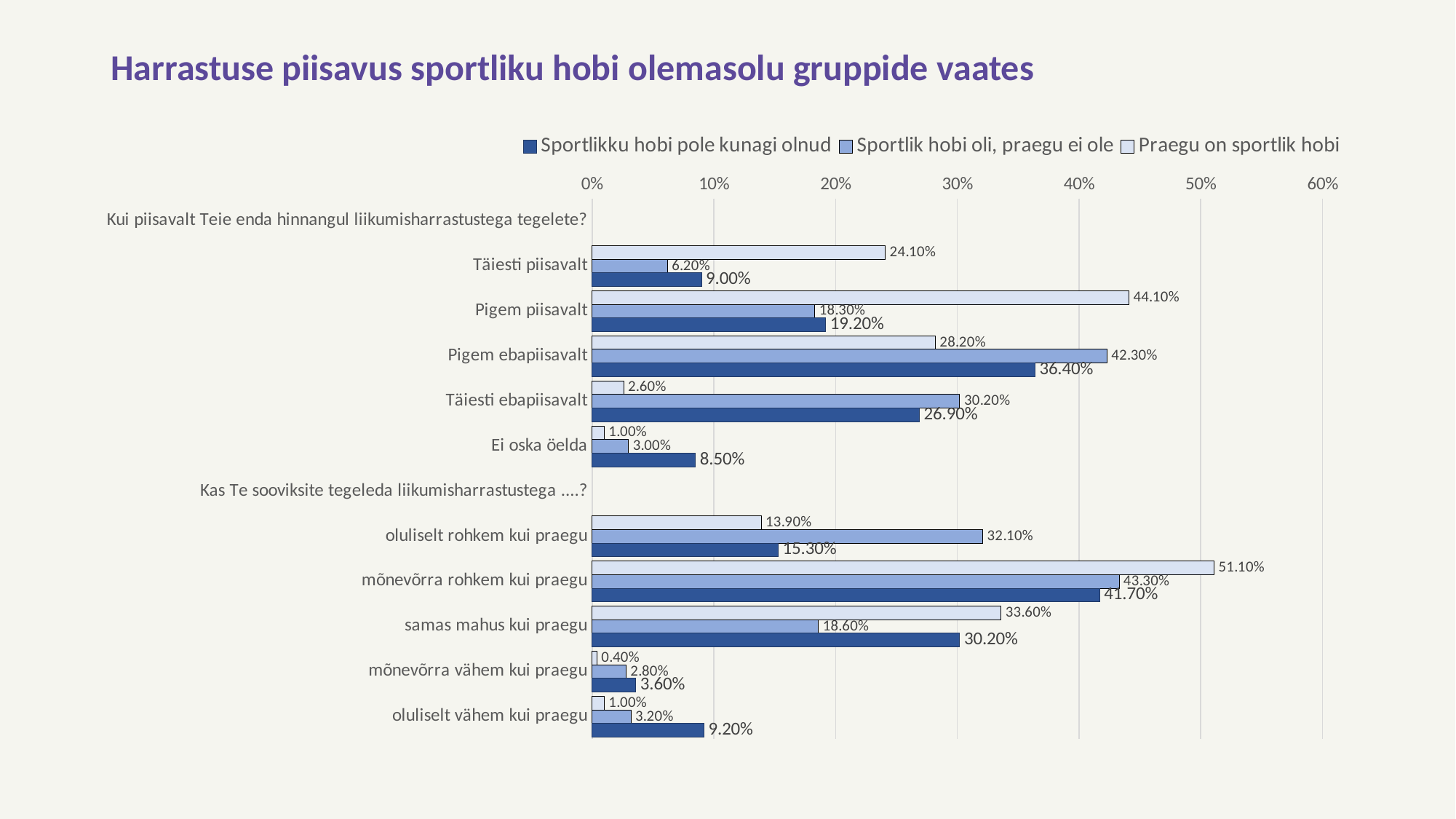
How many series does the legend list? 3 What is the difference between the "Praegu on sportlik hobi" and "Sportlikku hobi pole kunagi olnud" values in the "Täiesti piisavalt" category? 15.10% What is the value for "Sportlikku hobi pole kunagi olnud" in the "samas mahus kui praegu" category? 30.20% What is the value for "Sportlik hobi oli, praegu ei ole" in the "oluliselt rohkem kui praegu" category? 32.10% What is the value for "Praegu on sportlik hobi" in the "Pigem piisavalt" category? 44.10% What is the value for "Sportlikku hobi pole kunagi olnud" in the "Täiesti ebapiisavalt" category? 26.90% Which category has the lowest value for the "Praegu on sportlik hobi" series? mõnevõrra vähem kui praegu What is the title of the chart? Harrastuse piisavus sportliku hobi olemasolu gruppide vaates In the "Pigem ebapiisavalt" category, which series has the larger value: "Sportlik hobi oli, praegu ei ole" or "Praegu on sportlik hobi"? Sportlik hobi oli, praegu ei ole What type of chart is shown on the slide? bar chart Is the value for "Praegu on sportlik hobi" in the "mõnevõrra rohkem kui praegu" category greater or less than 50%? greater Which category has the highest value for the "Praegu on sportlik hobi" series? mõnevõrra rohkem kui praegu